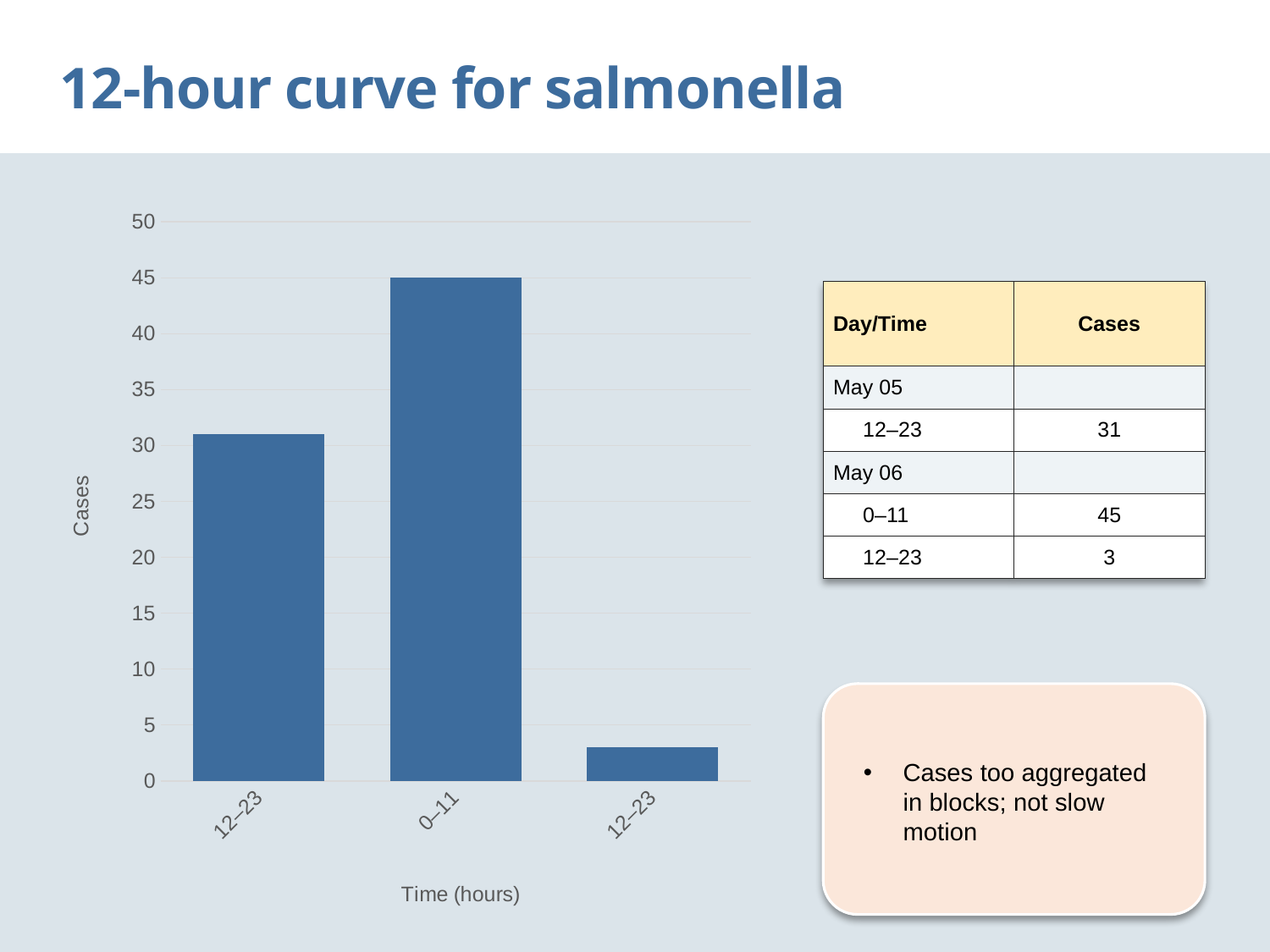
What is the number of cases for the last (rightmost) 12–23 bar, May 06? 3 What is the label of the x axis? Time (hours) Which has more cases, the 0–11 block or the leftmost 12–23 block? 0–11 Which bar has the lowest number of cases? the rightmost 12–23 bar (May 06) What is the number of cases for the first (leftmost) 12–23 bar, May 05? 31 What type of chart is shown on the slide? bar chart Which time block has the highest number of cases? 0–11 How many bars are plotted in the chart? 3 What is the difference in cases between the 0–11 block and the May 05 12–23 block? 14 What is the label of the y axis? Cases What is the number of cases for the 0–11 hour block? 45 Is the value for the leftmost 12–23 bar greater or less than 30? greater